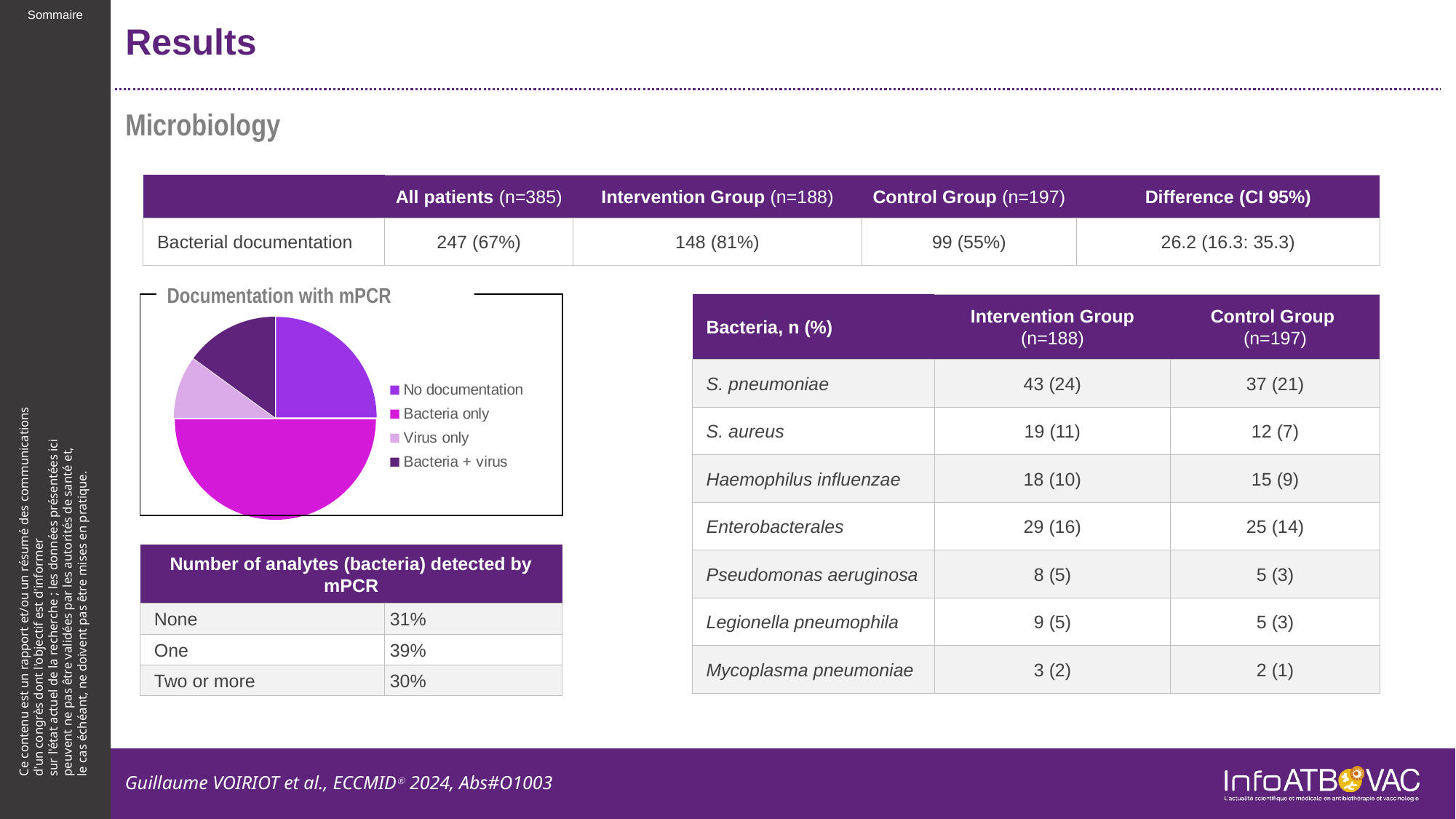
What is the title of the pie chart on the slide? Documentation with mPCR Which category has the largest slice in the "Documentation with mPCR" pie chart? Bacteria only What kind of chart is the "Documentation with mPCR" chart? pie chart In the "Documentation with mPCR" pie chart, which slice is larger: Bacteria only or Virus only? Bacteria only In the "Documentation with mPCR" pie chart, which slice is larger: No documentation or Bacteria + virus? No documentation How many entries does the legend of the "Documentation with mPCR" pie chart list? 4 Which category has the smallest slice in the "Documentation with mPCR" pie chart? Virus only How many slices does the "Documentation with mPCR" pie chart have? 4 In the "Documentation with mPCR" pie chart, which slice is larger: No documentation or Virus only? No documentation Which legend entry in the "Documentation with mPCR" pie chart is shown in the lightest (pale lilac) colour? Virus only